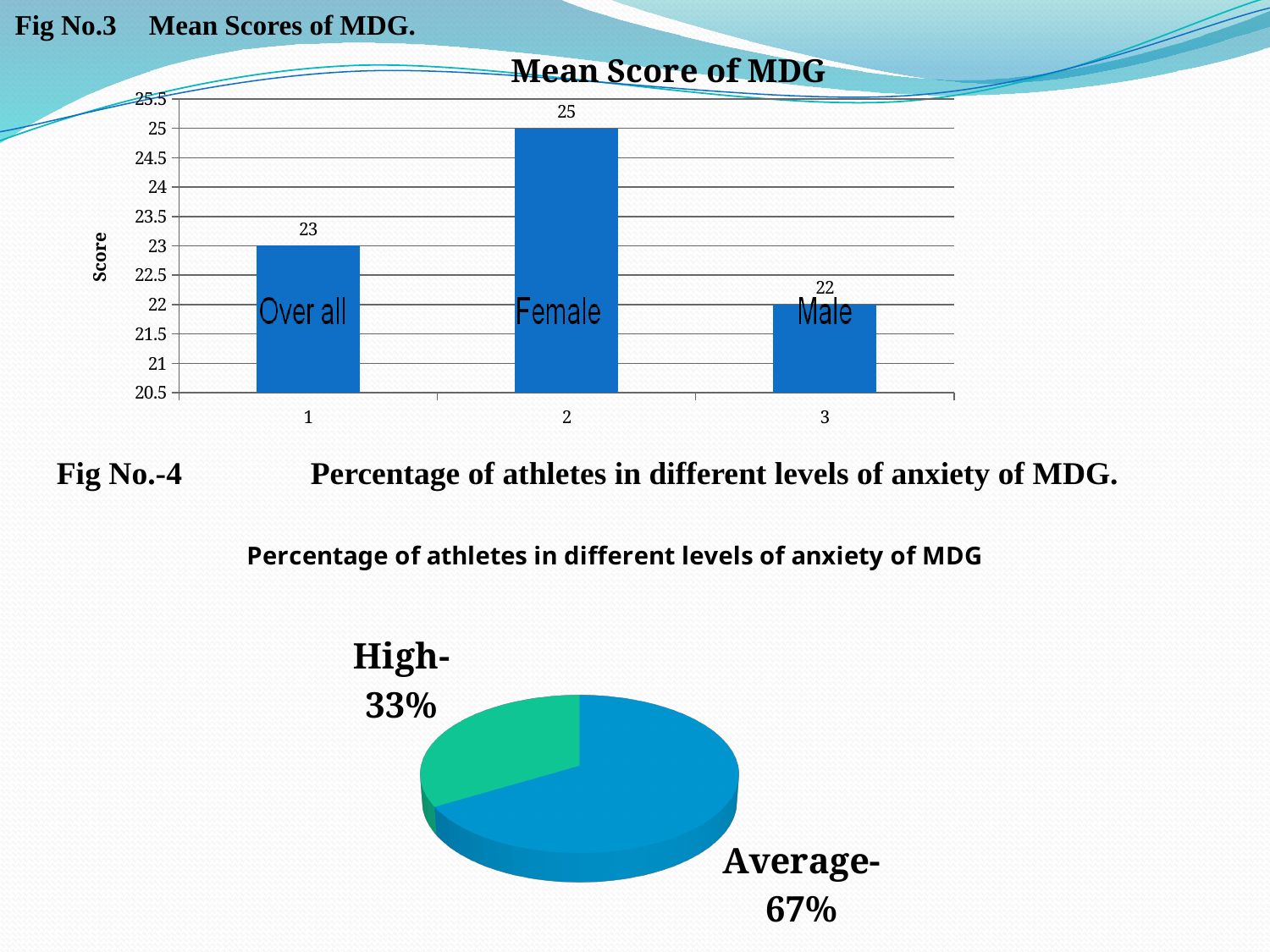
In the 'Mean Score of MDG' chart, which group has the lowest mean score? Male In the 'Mean Score of MDG' chart, what is the mean score for Over all? 23 In the 'Mean Score of MDG' chart, what is the mean score for Female? 25 What kind of chart is the 'Mean Score of MDG' chart? bar chart In the 'Mean Score of MDG' chart, what is the mean score for Male? 22 In the 'Mean Score of MDG' chart, what is the difference between the Female and Male mean scores? 3 In the 'Mean Score of MDG' chart, which is larger, the Over all score or the Male score? Over all In the 'Mean Score of MDG' chart, which group has the highest mean score? Female In the 'Percentage of athletes in different levels of anxiety of MDG' chart, what share of athletes have a High level of anxiety? 33% In the 'Percentage of athletes in different levels of anxiety of MDG' chart, what share of athletes have an Average level of anxiety? 67% How many bars are shown in the 'Mean Score of MDG' chart? 3 What kind of chart is the 'Percentage of athletes in different levels of anxiety of MDG' chart? pie chart